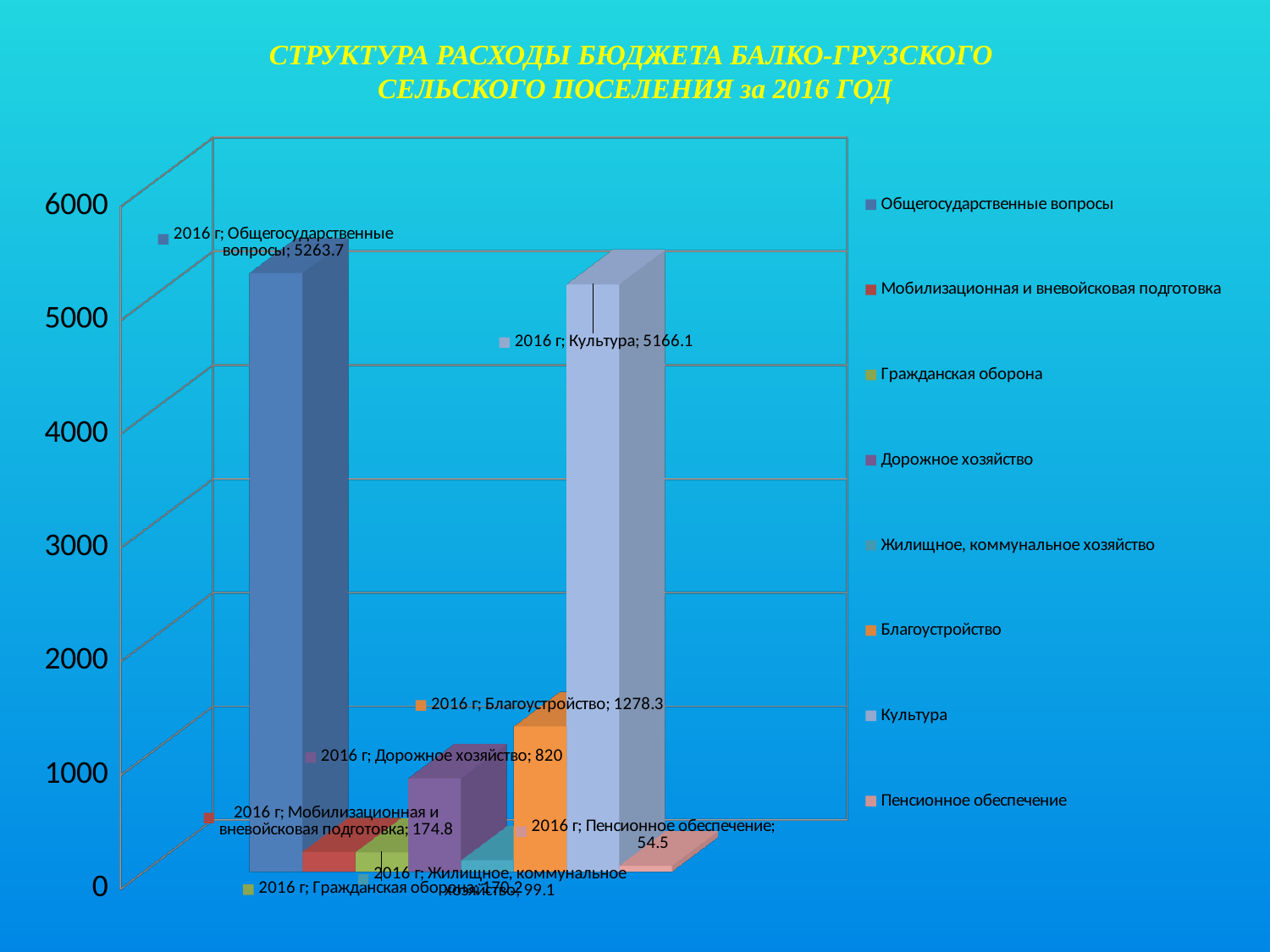
What kind of chart is shown on the slide? Bar chart What is the value for Дорожное хозяйство? 820 Which category has the highest value? Общегосударственные вопросы Which category has the lowest value? Пенсионное обеспечение How many entries does the legend list? 8 What is the value for Благоустройство? 1278.3 What is the value for Общегосударственные вопросы? 5263.7 What is the value for Пенсионное обеспечение? 54.5 What is the value for Мобилизационная и вневойсковая подготовка? 174.8 What is the value for Культура? 5166.1 What is the difference between the values for Общегосударственные вопросы and Культура? 97.6 Which is larger, the value for Благоустройство or the value for Дорожное хозяйство? Благоустройство